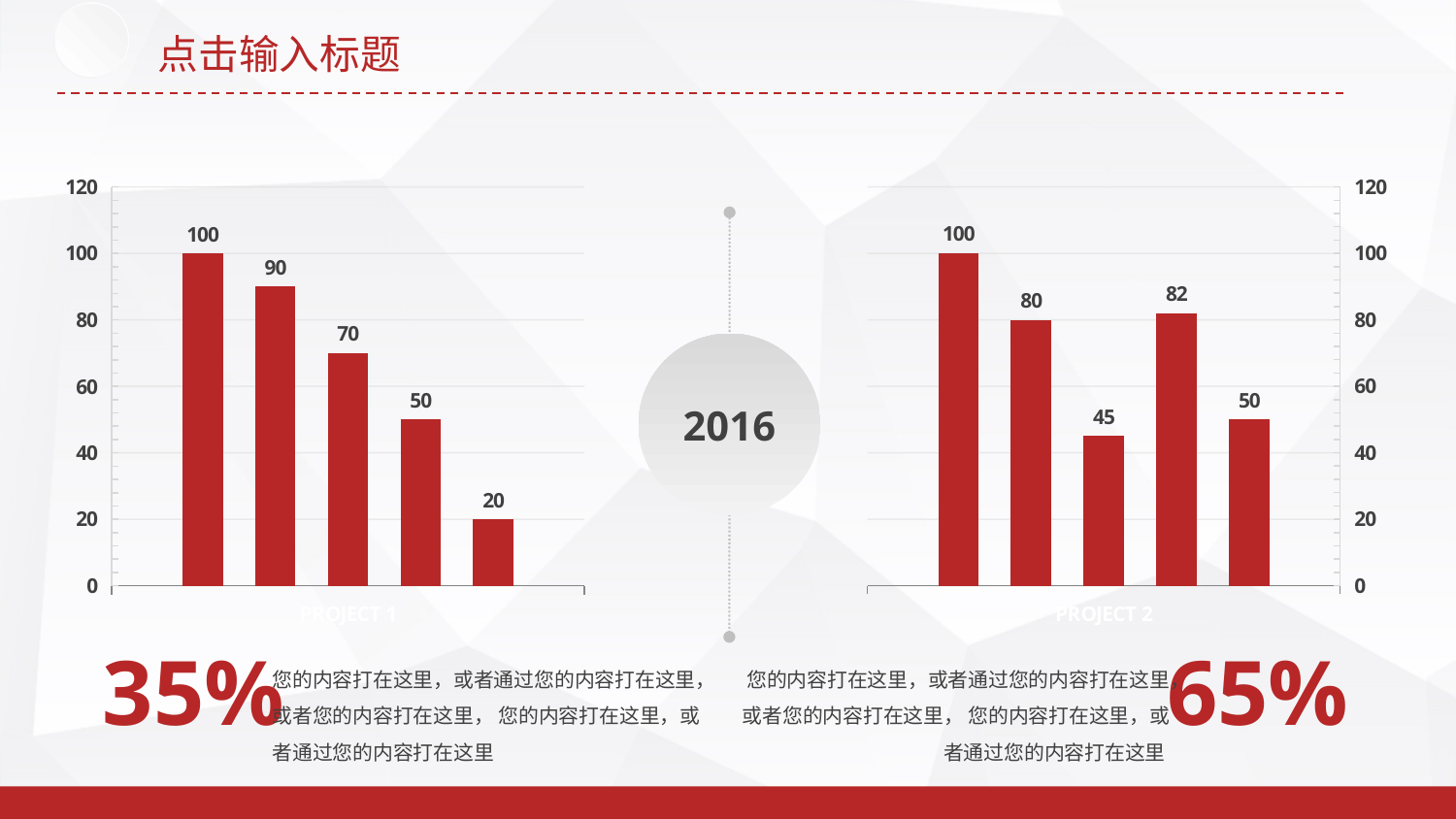
What type of chart is shown on the left side of the slide? Bar chart In the right chart, what is the value of the fourth bar? 82 In the left chart, do the values rise or fall from left to right? Fall In the right chart, what is the value of the third bar? 45 In the left chart, what is the value of the first bar? 100 In the left chart, which bar has the lowest value? The fifth bar (20) In the left chart, what is the value of the last (fifth) bar? 20 In the right chart, is the fourth bar (82) larger or smaller than the second bar (80)? Larger In the right chart, what is the difference between the second bar and the third bar? 35 In the left chart, what is the difference between the first bar and the second bar? 10 In the right chart, which bar has the highest value? The first bar (100) How many bars are in the left chart? 5